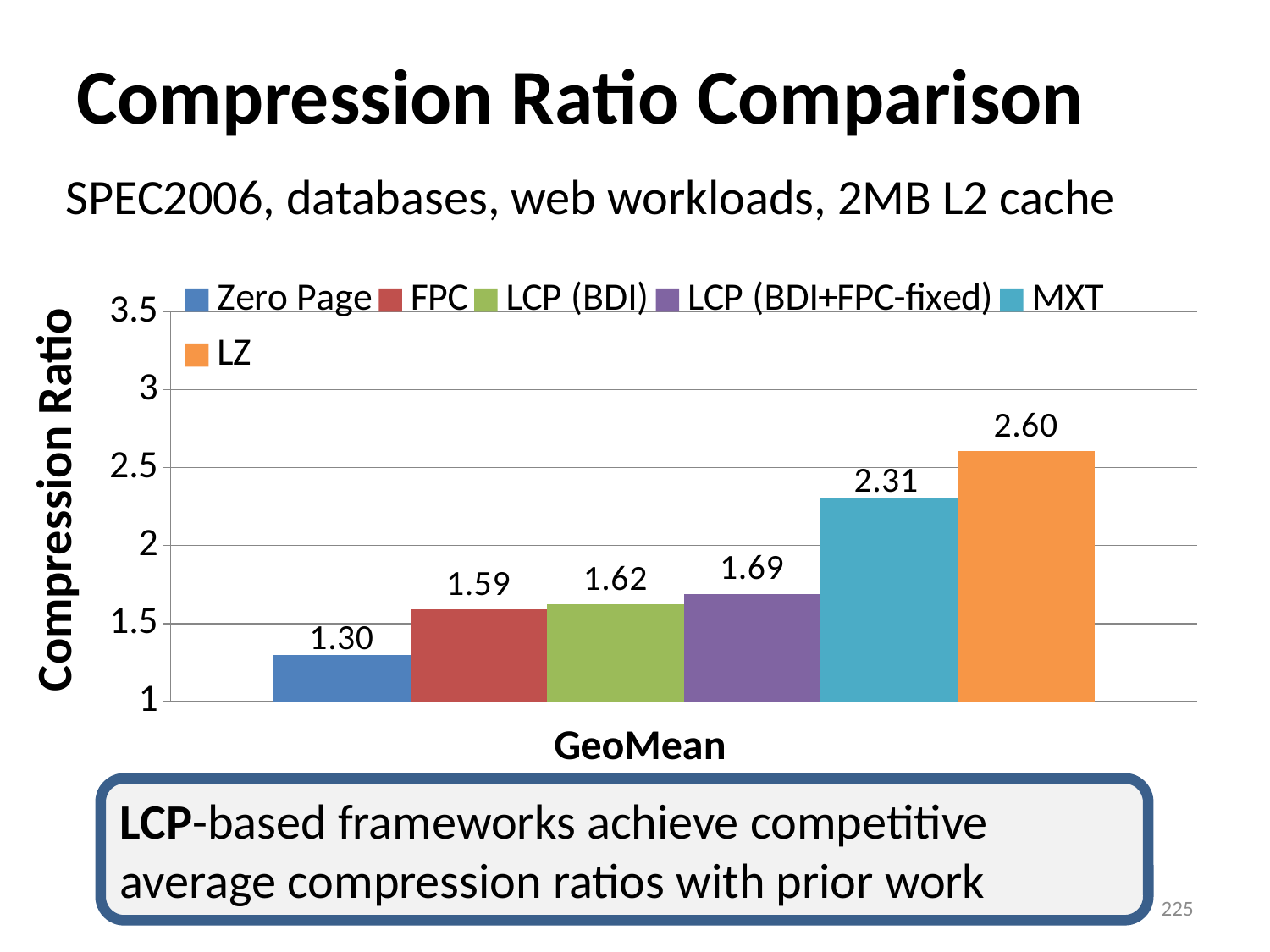
What is the compression ratio for LZ? 2.60 Which series has the highest compression ratio? LZ What is the difference between the compression ratios of LZ and MXT? 0.29 What is the compression ratio for LCP (BDI+FPC-fixed)? 1.69 What is the difference between the compression ratios of LCP (BDI) and FPC? 0.03 Which series has the lowest compression ratio? Zero Page How many series does the legend list? 6 What is the label on the x axis of the chart? GeoMean What is the compression ratio for Zero Page? 1.30 Which has a higher compression ratio, MXT or LCP (BDI+FPC-fixed)? MXT What is the compression ratio for MXT? 2.31 What kind of chart is shown on the slide? Bar chart